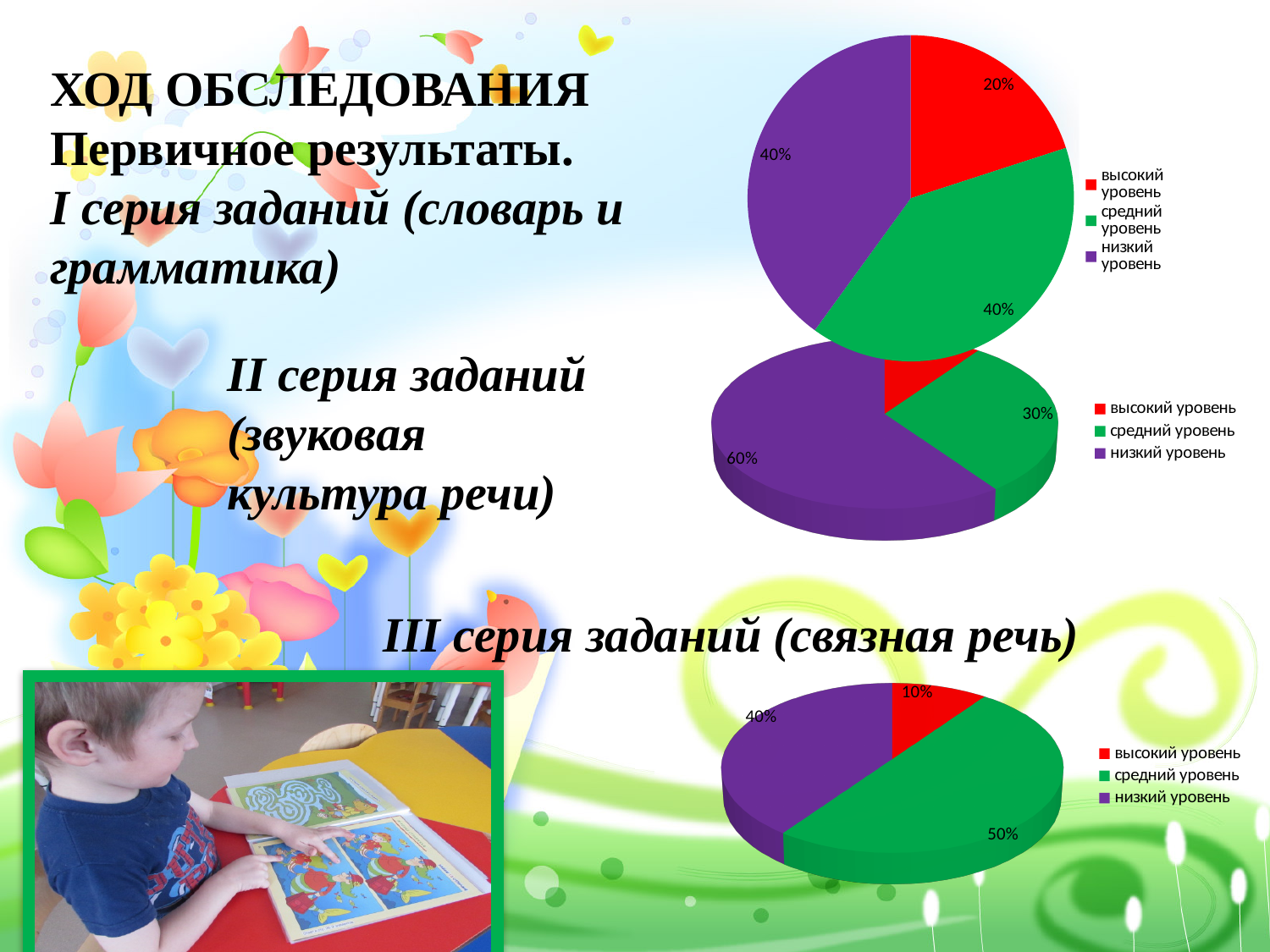
What kind of chart is the top chart on the slide? pie chart In the middle pie chart, which category has the smallest share? высокий уровень In the middle pie chart, what percentage is shown for средний уровень? 30% In the top pie chart, which category has the smallest share? высокий уровень In the bottom pie chart, which is larger: the share of низкий уровень or the share of высокий уровень? низкий уровень In the top pie chart, what percentage is shown for высокий уровень? 20% In the top pie chart, what percentage is shown for средний уровень? 40% How many categories does the legend of the bottom pie chart list? 3 In the top pie chart, what is the difference between the shares of низкий уровень and высокий уровень? 20% In the bottom pie chart, what percentage is shown for средний уровень? 50% In the middle pie chart, what percentage is shown for низкий уровень? 60% In the middle pie chart, which category has the largest share? низкий уровень